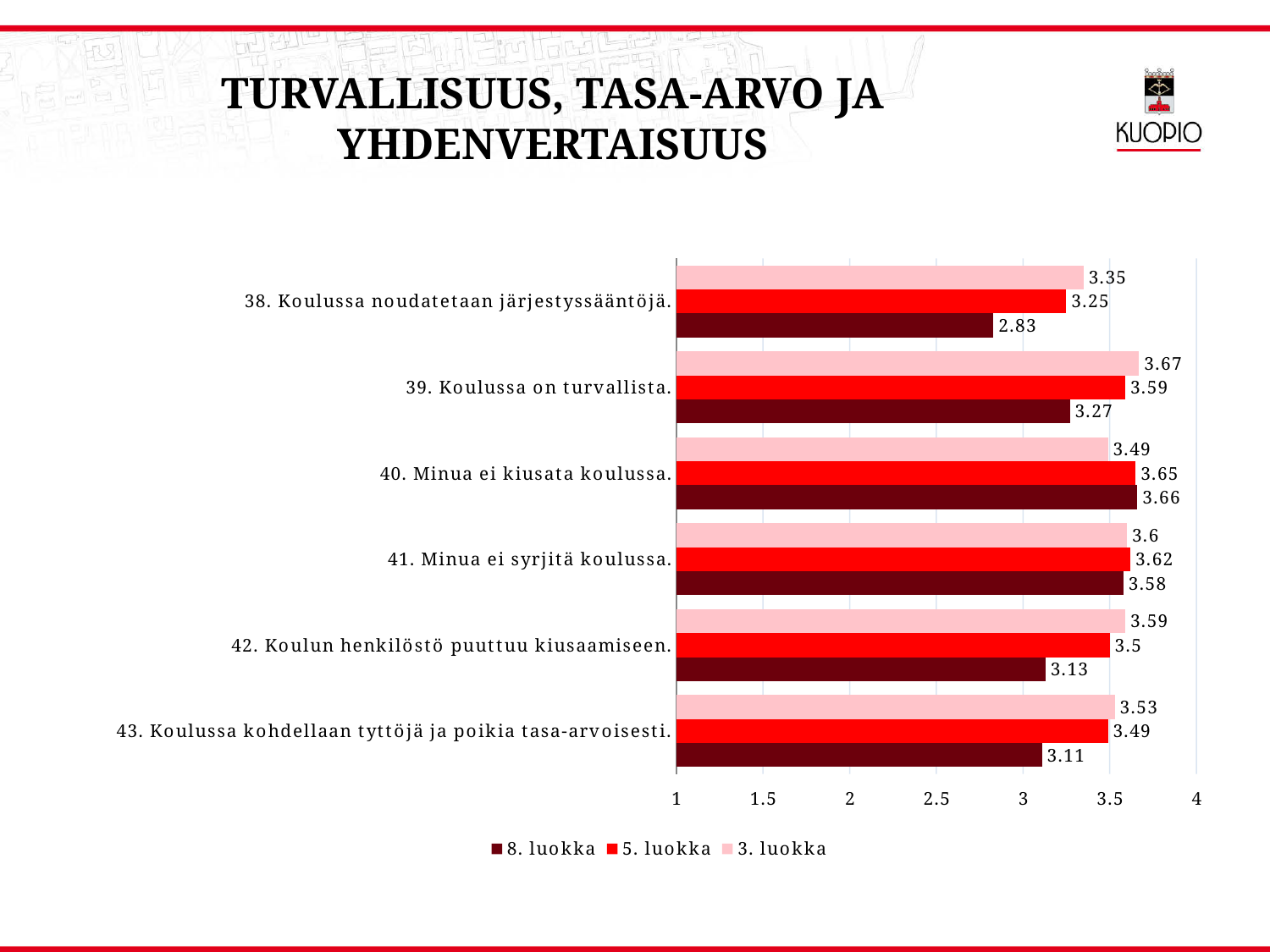
On item 42, which is larger: the value for 3. luokka or for 8. luokka? 3. luokka What kind of chart is shown on the slide? bar chart Which item has the lowest value for 8. luokka? 38. Koulussa noudatetaan järjestyssääntöjä. Is the value for 8. luokka on item 38 greater or less than 3? less What is the difference between the 3. luokka and 8. luokka values on item 38? 0.52 What is the value for 8. luokka on item 43 (Koulussa kohdellaan tyttöjä ja poikia tasa-arvoisesti)? 3.11 How many series does the legend list? 3 What is the value for 8. luokka on item 38 (Koulussa noudatetaan järjestyssääntöjä)? 2.83 Which item has the highest value for 3. luokka? 39. Koulussa on turvallista. What is the value for 3. luokka on item 39 (Koulussa on turvallista)? 3.67 How many items (categories) are shown on the chart? 6 What is the value for 5. luokka on item 42 (Koulun henkilöstö puuttuu kiusaamiseen)? 3.5